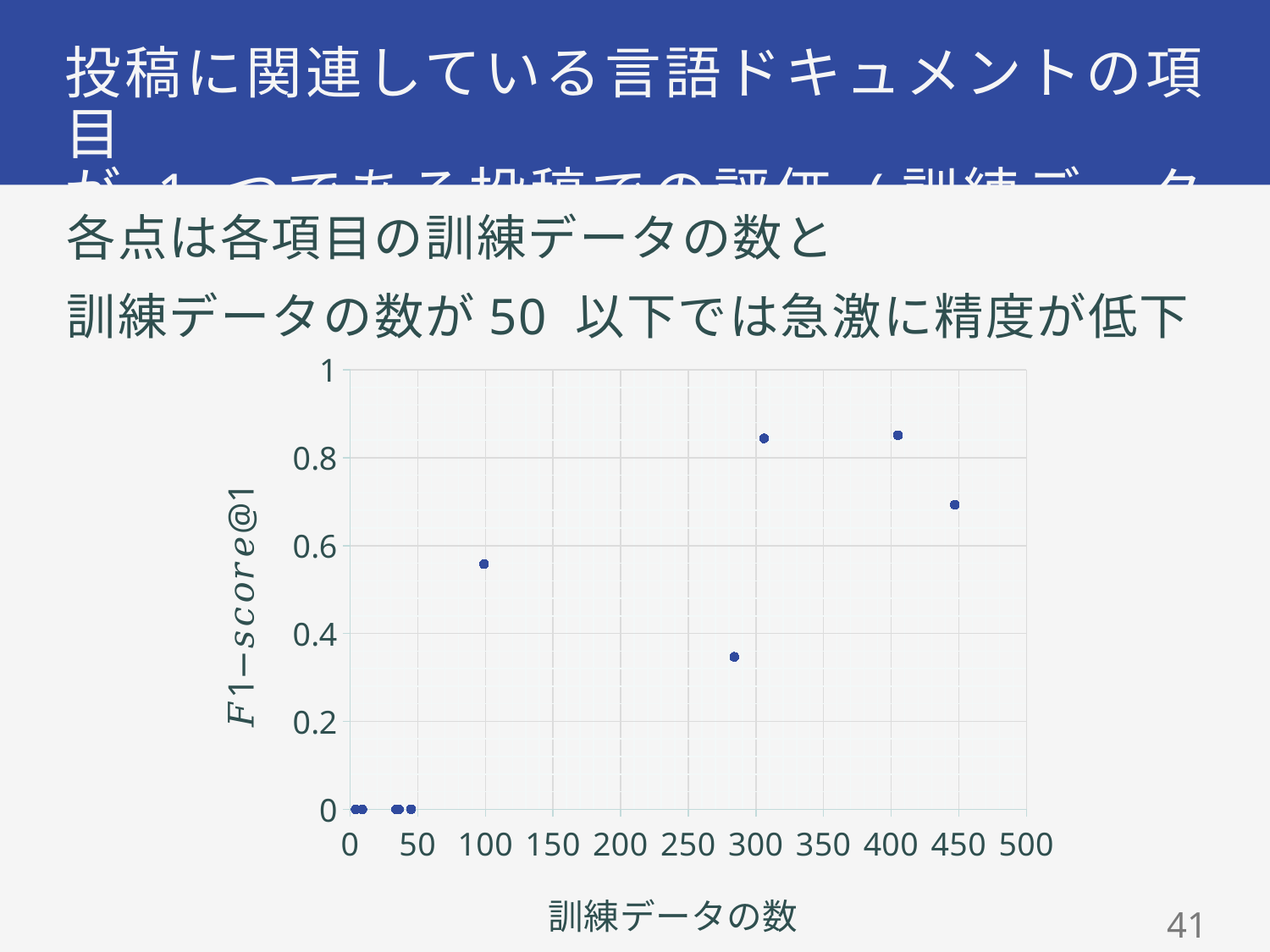
Is the F1-score@1 value for the point at about 285 training samples greater or less than 0.4? less Are the F1-score@1 values for all points with fewer than 50 training samples greater or less than 0.2? less How many points have an F1-score@1 above 0.5? 4 Is the F1-score@1 value for the point at about 100 training samples greater or less than 0.5? greater What is the highest value shown on the x axis? 500 What is the label of the y axis of the chart? F1-score@1 What is the label of the x axis of the chart? 訓練データの数 What kind of chart is shown on the slide? scatter plot Which has the higher F1-score@1: the point at about 100 training samples or the point at about 285 training samples? the point at about 100 training samples